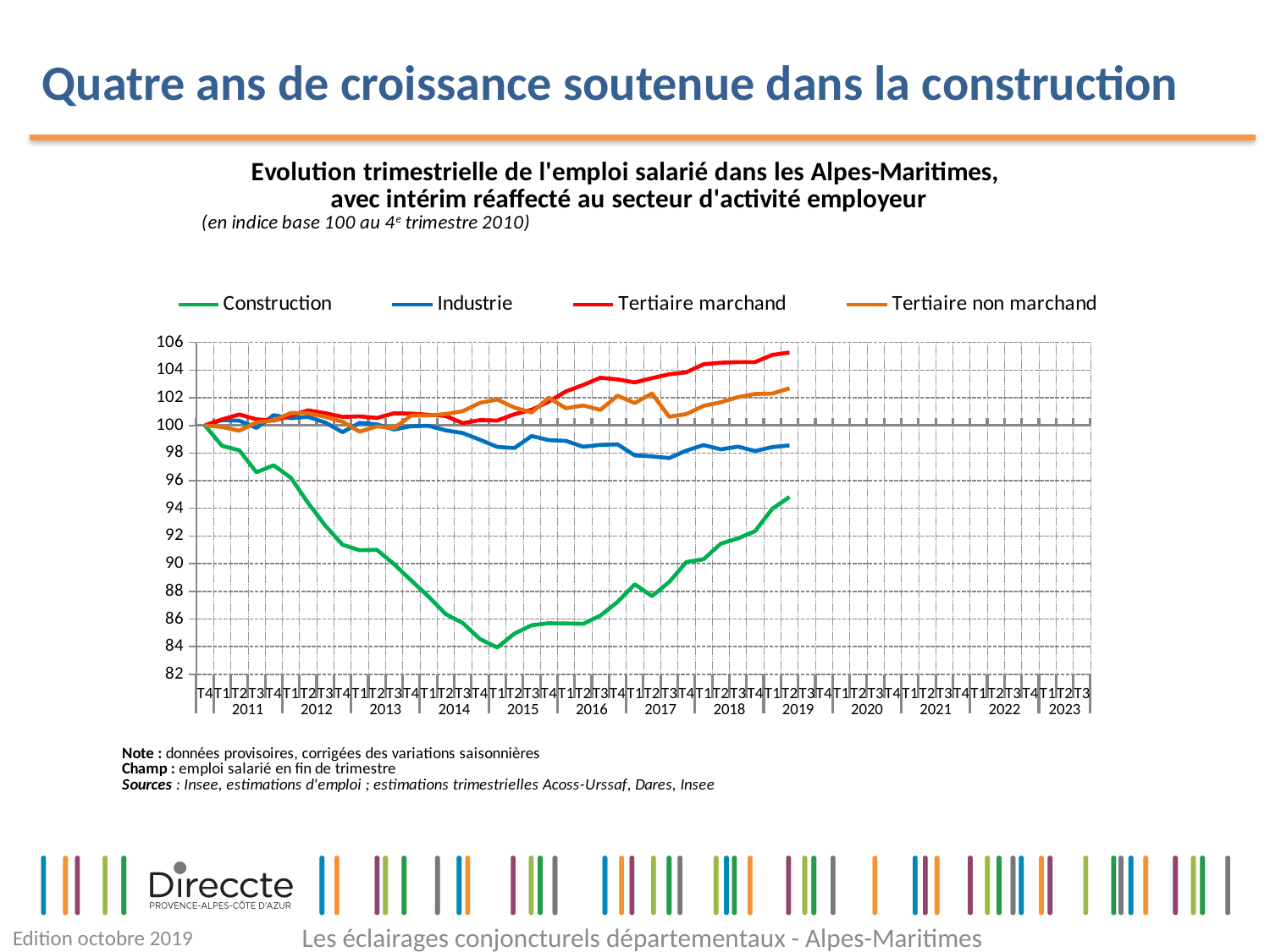
Is the value for Construction at T4 2014 greater or less than 86? less Which colour is used for the Construction series? green Which series has the lowest value at the last point shown (T3 2019)? Construction What kind of chart is shown on the slide? line chart Does the Construction series rise or fall between T4 2010 and T4 2014? fall What is the index value of all four series at T4 2010, the base period? 100 How many series does the legend list? 4 Which series has the highest value at the last point shown (T3 2019)? Tertiaire marchand